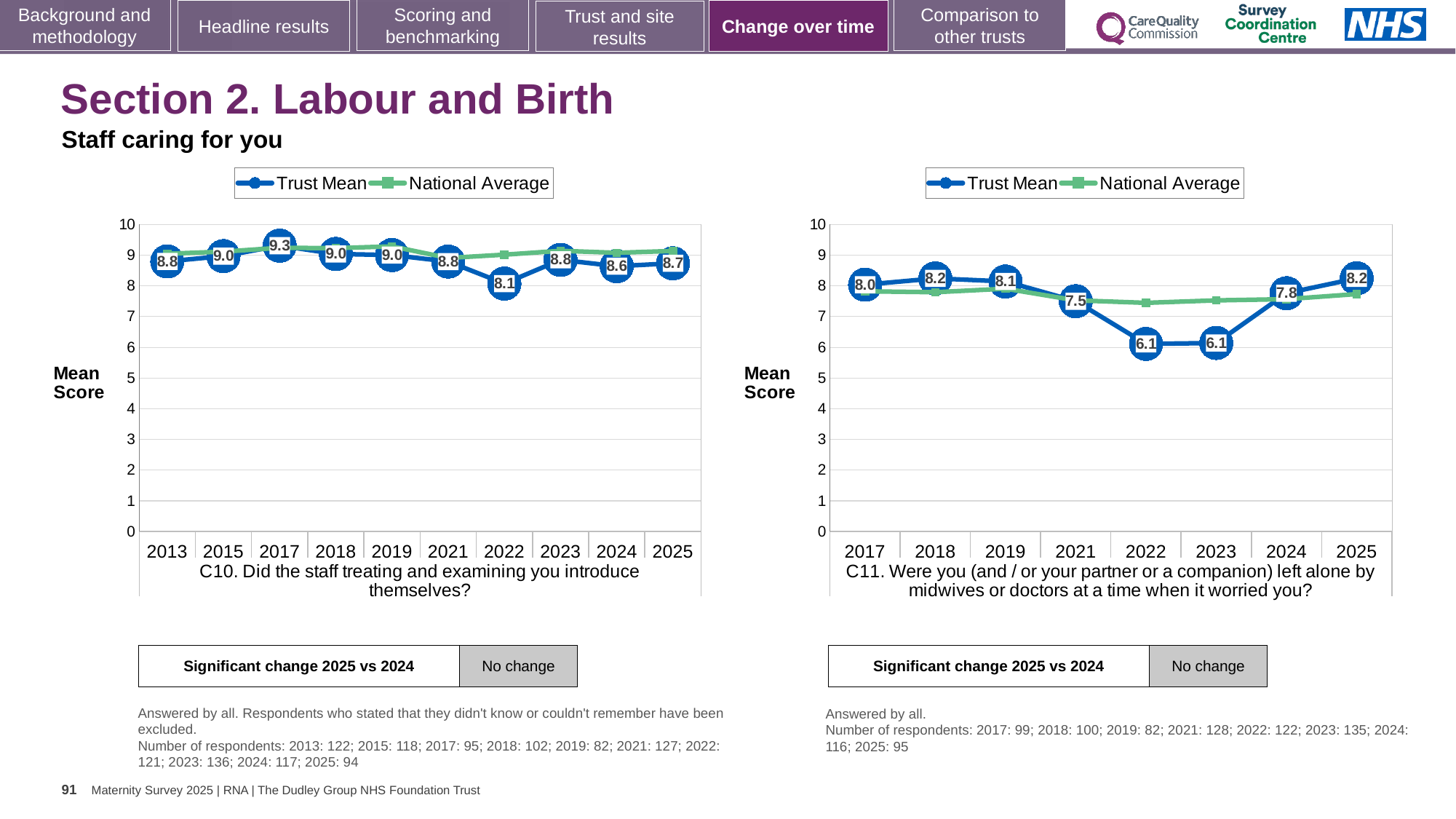
In the C10 chart (left), how many years are shown on the x axis? 10 In the C11 chart (right), what is the difference between the Trust Mean scores for 2025 and 2024? 0.4 In the C10 chart (left), which year has the highest Trust Mean score? 2017 In the C11 chart (right), what is the Trust Mean score for 2025? 8.2 In the C10 chart (left), what is the Trust Mean score for 2017? 9.3 In the C11 chart (right), is the Trust Mean score for 2021 larger than the score for 2022? Yes How many series does the legend of the C11 chart (right) list? 2 In the C10 chart (left), what is the Trust Mean score for 2022? 8.1 In the C11 chart (right), what is the Trust Mean score for 2022? 6.1 In the C11 chart (right), is the National Average for 2022 greater or less than 8? less In the C10 chart (left), what is the difference between the Trust Mean scores for 2017 and 2022? 1.2 In the C10 chart (left), which year has the lowest Trust Mean score? 2022